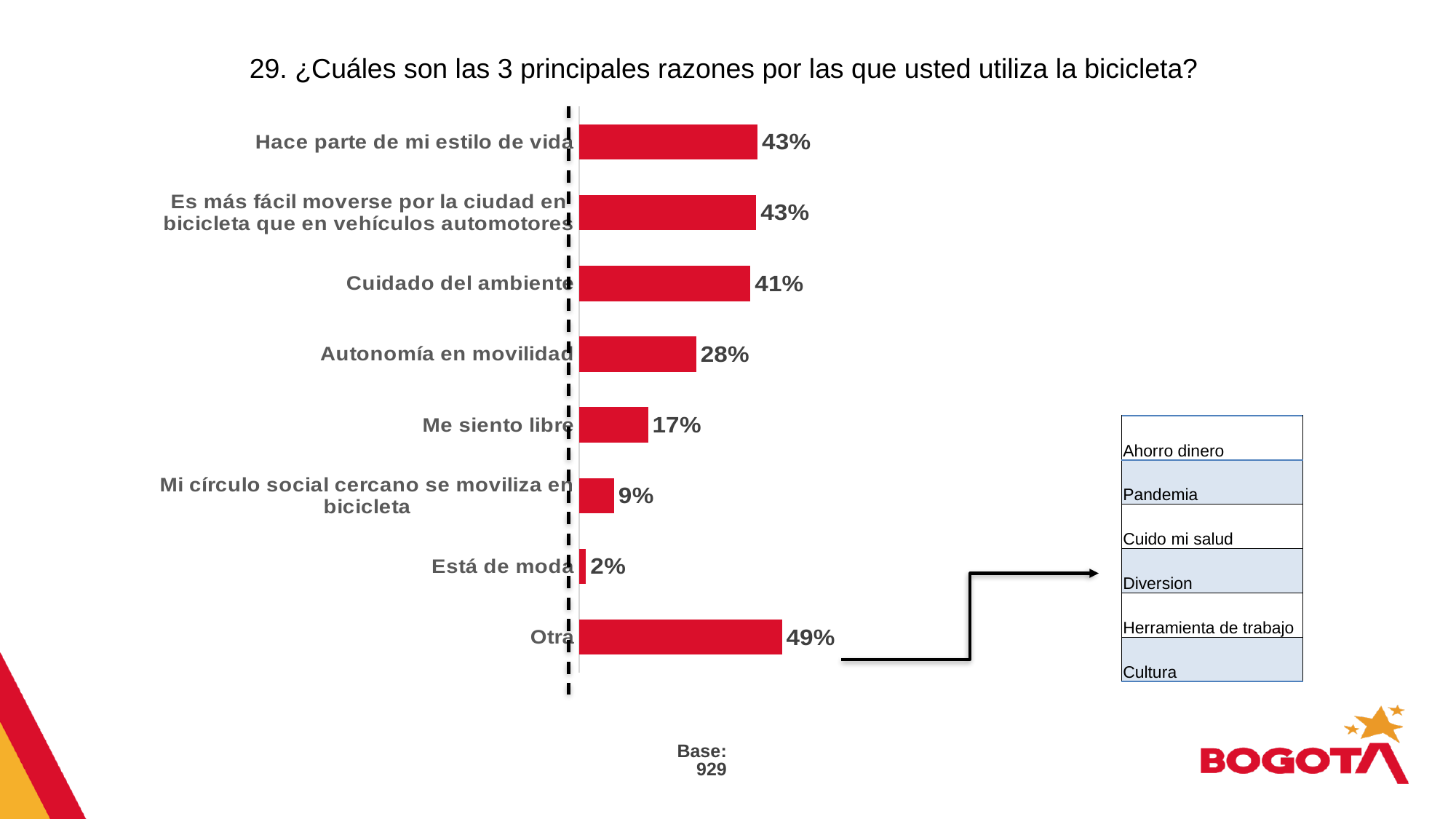
What is the value for "Me siento libre"? 17% Which is larger: "Autonomía en movilidad" or "Mi círculo social cercano se moviliza en bicicleta"? Autonomía en movilidad What is the base (number of respondents) shown below the chart? 929 How many categories are shown in the chart? 8 Which category has the lowest value? Está de moda What is the value for "Cuidado del ambiente"? 41% What is the difference between "Hace parte de mi estilo de vida" and "Me siento libre"? 26% What colour are the bars in the chart? Red What kind of chart is shown on the slide? Bar chart What is the value for "Está de moda"? 2% What is the value for "Autonomía en movilidad"? 28% Which category has the highest value? Otra